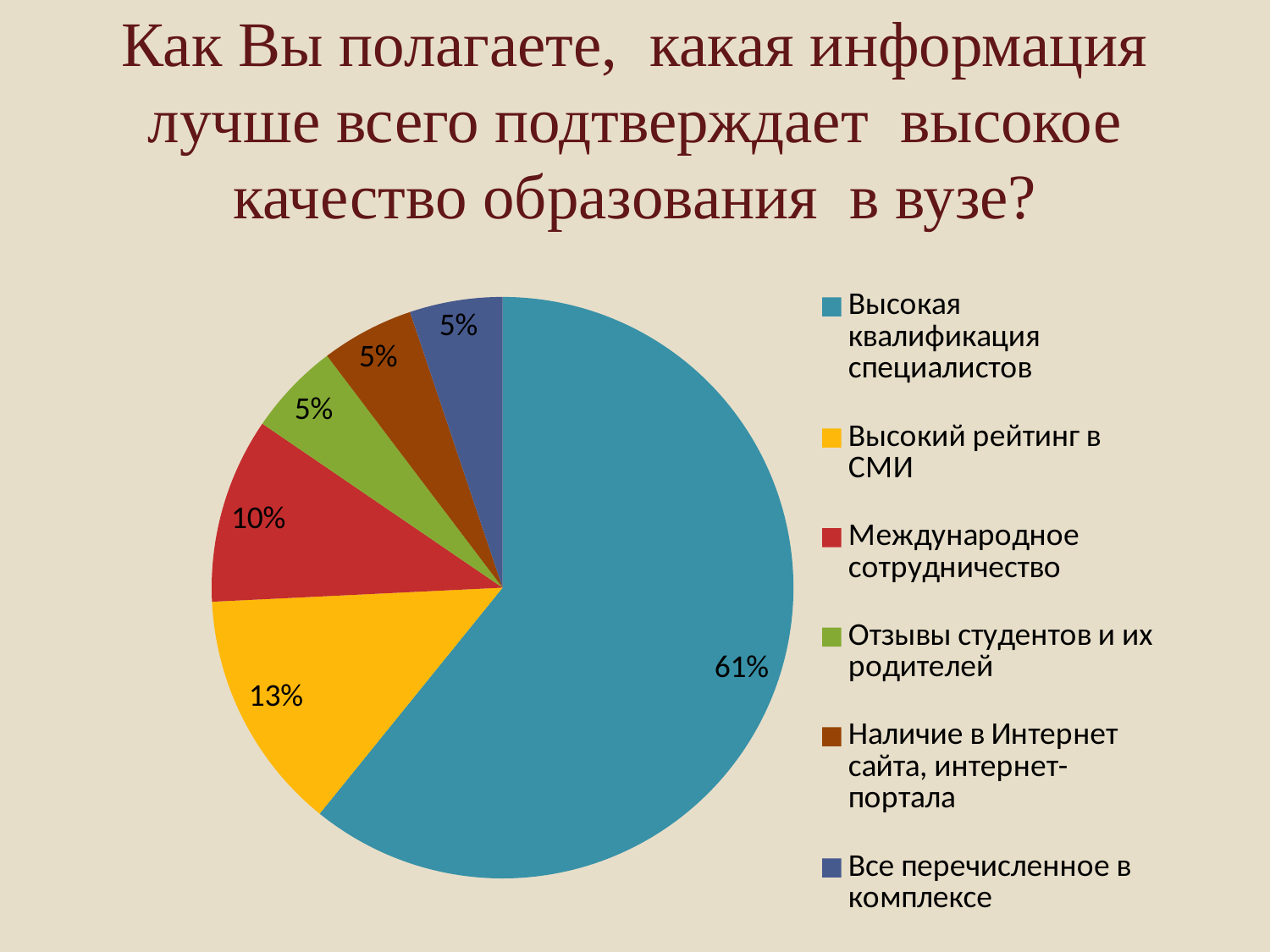
What kind of chart is shown on the slide? pie chart What is the difference in percentage points between "Высокая квалификация специалистов" and "Высокий рейтинг в СМИ"? 48 Which category has the largest slice of the pie? Высокая квалификация специалистов What colour is the slice for "Высокий рейтинг в СМИ"? yellow What share of the pie does "Высокий рейтинг в СМИ" have? 13% What share of the pie does "Международное сотрудничество" have? 10% What share of the pie does "Отзывы студентов и их родителей" have? 5% What share of the pie does "Высокая квалификация специалистов" have? 61% What is the difference in percentage points between "Высокий рейтинг в СМИ" and "Международное сотрудничество"? 3 What share of the pie does "Все перечисленное в комплексе" have? 5% How many slices does the pie chart have? 6 Which is larger: the slice for "Международное сотрудничество" or the slice for "Наличие в Интернет сайта, интернет-портала"? Международное сотрудничество